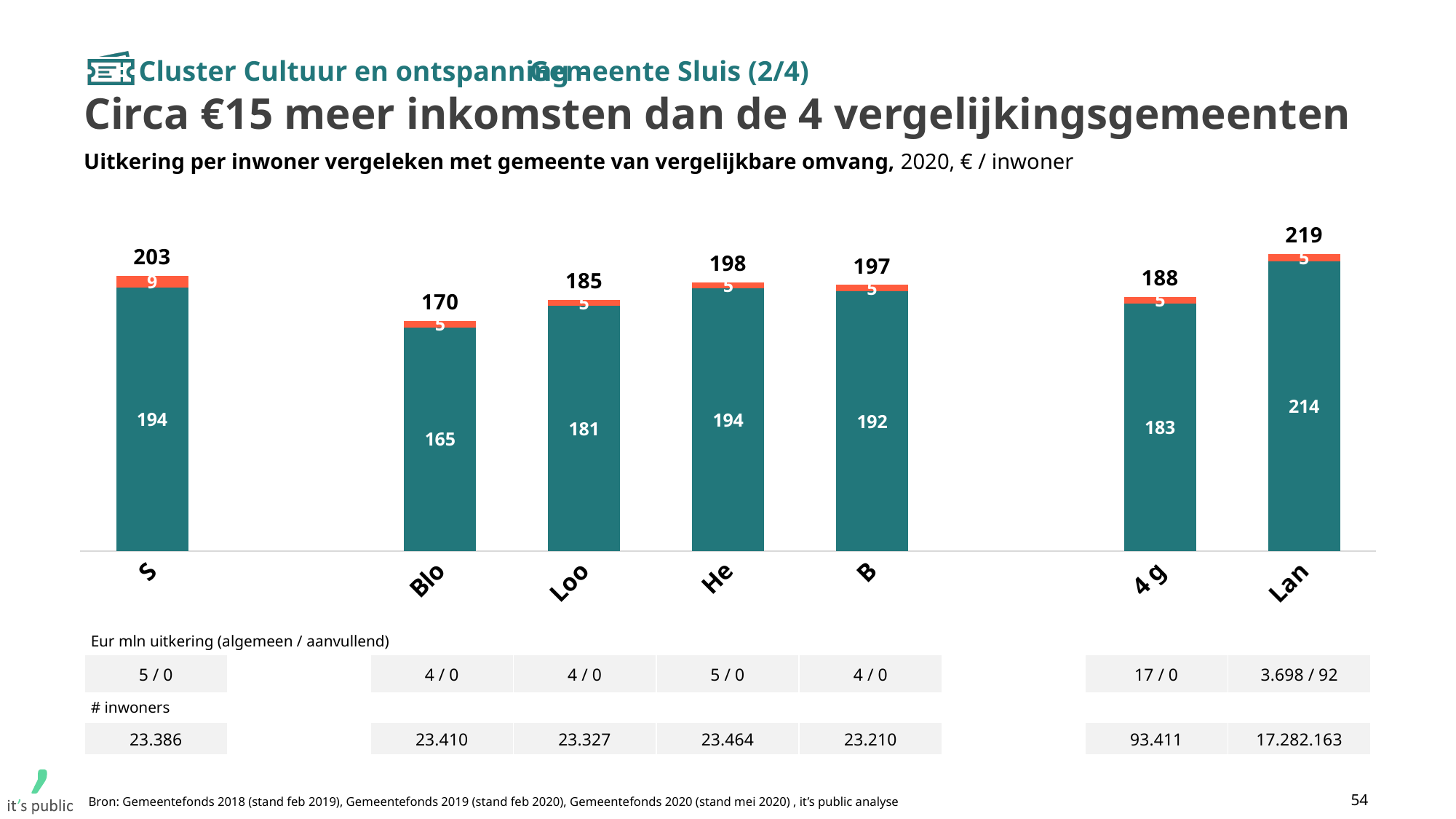
Which category has the highest total? Lan What kind of chart is shown on the slide? Stacked bar chart What is the total value shown above the bar for Loo? 185 Which category has the lowest total? Blo Which has a larger total, He or B? He What is the difference between the totals for Lan and S? 16 What is the difference between the totals for S and 4 g? 15 What is the total value shown above the bar for S? 203 What is the value of the teal (lower) segment for Blo? 165 How many bars are shown in the chart? 7 What is the value of the orange (upper) segment for S? 9 What is the value of the teal (lower) segment for Lan? 214